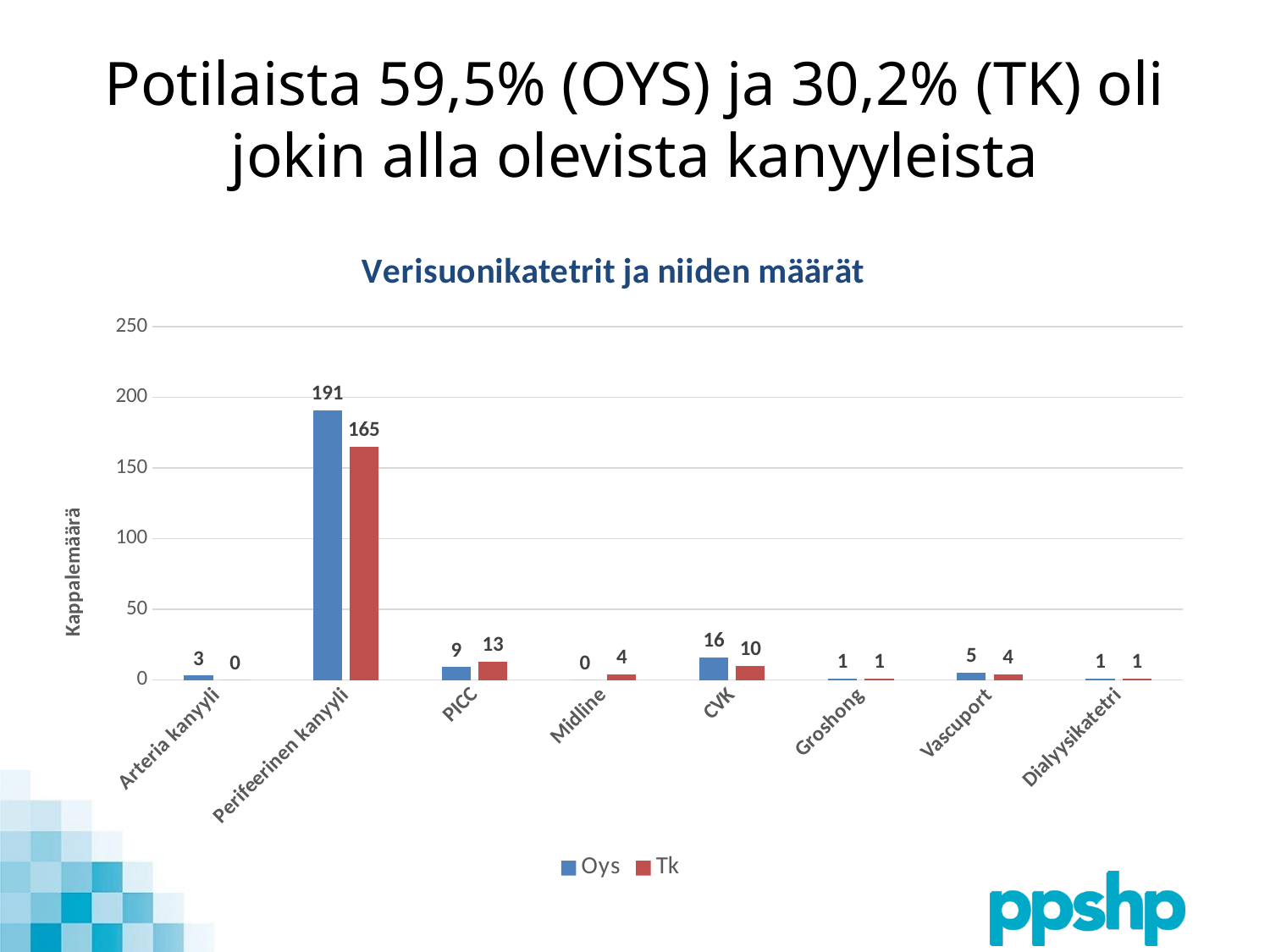
What is the Tk value for Midline? 4 Which is larger for CVK, the Oys value or the Tk value? Oys Is the Tk value for Perifeerinen kanyyli greater or less than 150? greater How many series does the legend list? 2 What is the Tk value for PICC? 13 What kind of chart is shown? bar chart What is the title of the chart? Verisuonikatetrit ja niiden määrät How many categories are shown on the x axis? 8 What is the Oys value for CVK? 16 What is the difference between the Oys and Tk values for Perifeerinen kanyyli? 26 Which category has the highest Tk value? Perifeerinen kanyyli What is the Oys value for Perifeerinen kanyyli? 191